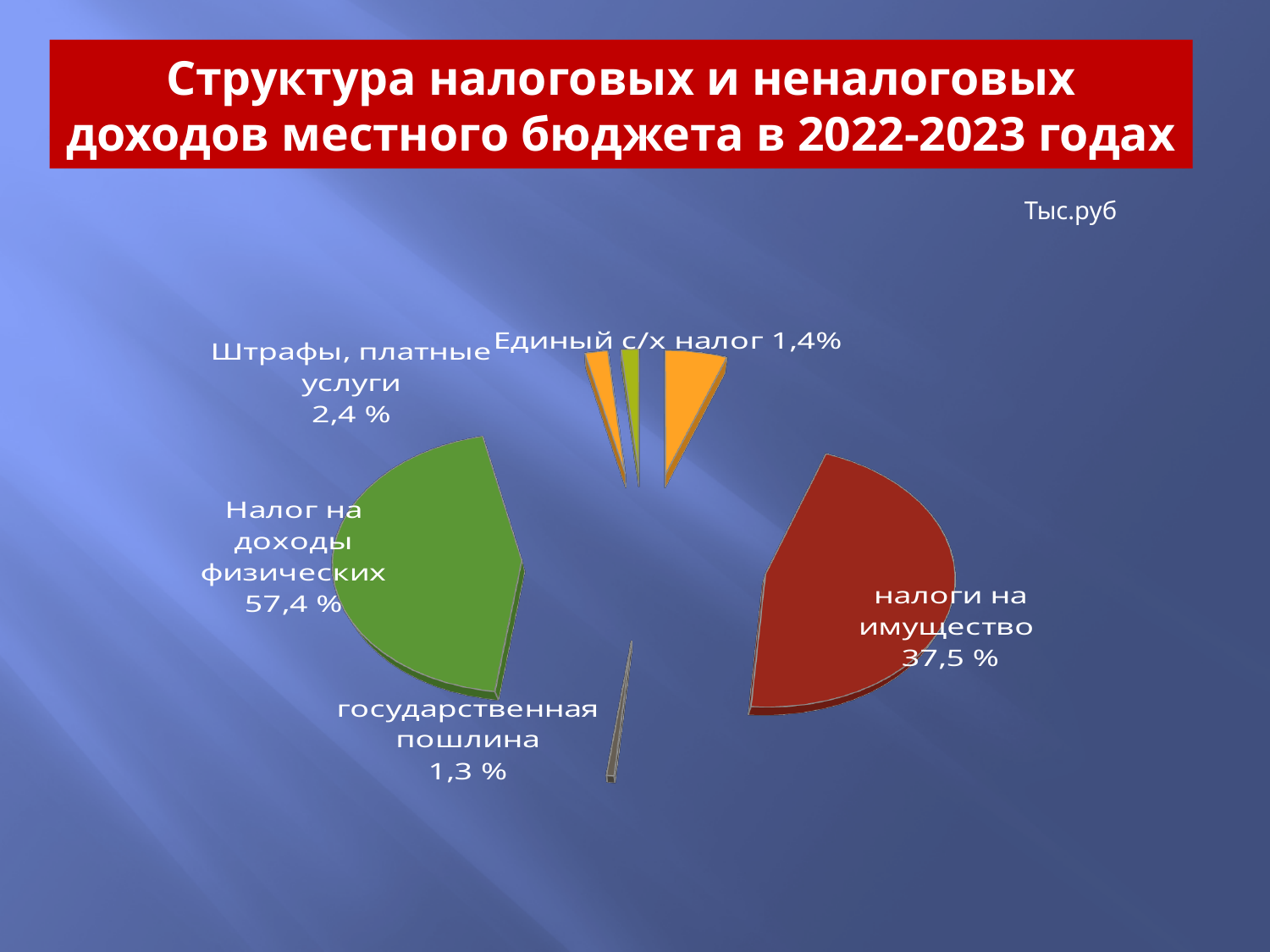
Which is larger: the share for "налоги на имущество" or the share for "Штрафы, платные услуги"? налоги на имущество What share of the pie does "Налог на доходы физических" have? 57,4 % What share of the pie does "налоги на имущество" have? 37,5 % What is the difference in percentage points between "Налог на доходы физических" and "налоги на имущество"? 19,9 Which category has the smallest slice of the pie? государственная пошлина Which category has the largest slice of the pie? Налог на доходы физических What share of the pie does "государственная пошлина" have? 1,3 % What share of the pie does "Штрафы, платные услуги" have? 2,4 % What type of chart is shown on the slide? Pie chart What share of the pie does "Единый с/х налог" have? 1,4% What is the title of the slide? Структура налоговых и неналоговых доходов местного бюджета в 2022-2023 годах How many slices does the pie chart have? 6